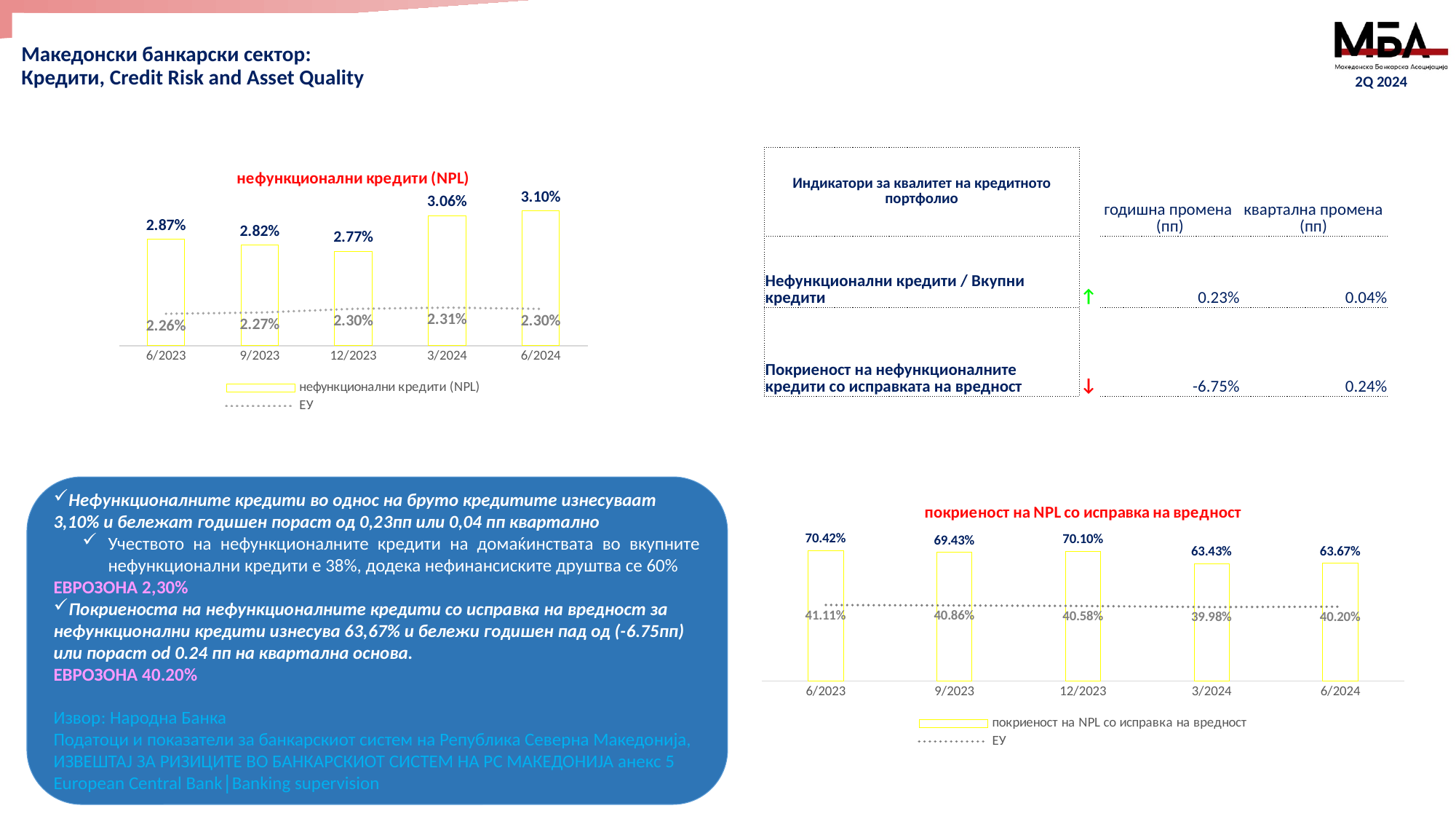
In the chart titled "покриеност на NPL со исправка на вредност", what is the ЕУ value for 6/2024? 40.20% In the chart titled "нефункционални кредити (NPL)", how many periods are shown on the x axis? 5 In the chart titled "нефункционални кредити (NPL)", what is the NPL value for 6/2024? 3.10% In the chart titled "нефункционални кредити (NPL)", what is the ЕУ value for 12/2023? 2.30% In the chart titled "покриеност на NPL со исправка на вредност", what is the bar value for 3/2024? 63.43% In the chart titled "нефункционални кредити (NPL)", how many series does the legend list? 2 In the chart titled "нефункционални кредити (NPL)", which period has the lowest NPL bar? 12/2023 In the chart titled "покриеност на NPL со исправка на вредност", what is the difference between the bar for 6/2023 and the bar for 6/2024? 6.75% In the chart titled "нефункционални кредити (NPL)", what is the difference between the NPL bar for 6/2024 and the NPL bar for 6/2023? 0.23% What kind of chart is the chart titled "покриеност на NPL со исправка на вредност"? Bar chart with a line In the chart titled "покриеност на NPL со исправка на вредност", which is larger: the bar for 9/2023 or the bar for 12/2023? 12/2023 In the chart titled "покриеност на NPL со исправка на вредност", which period has the highest bar? 6/2023